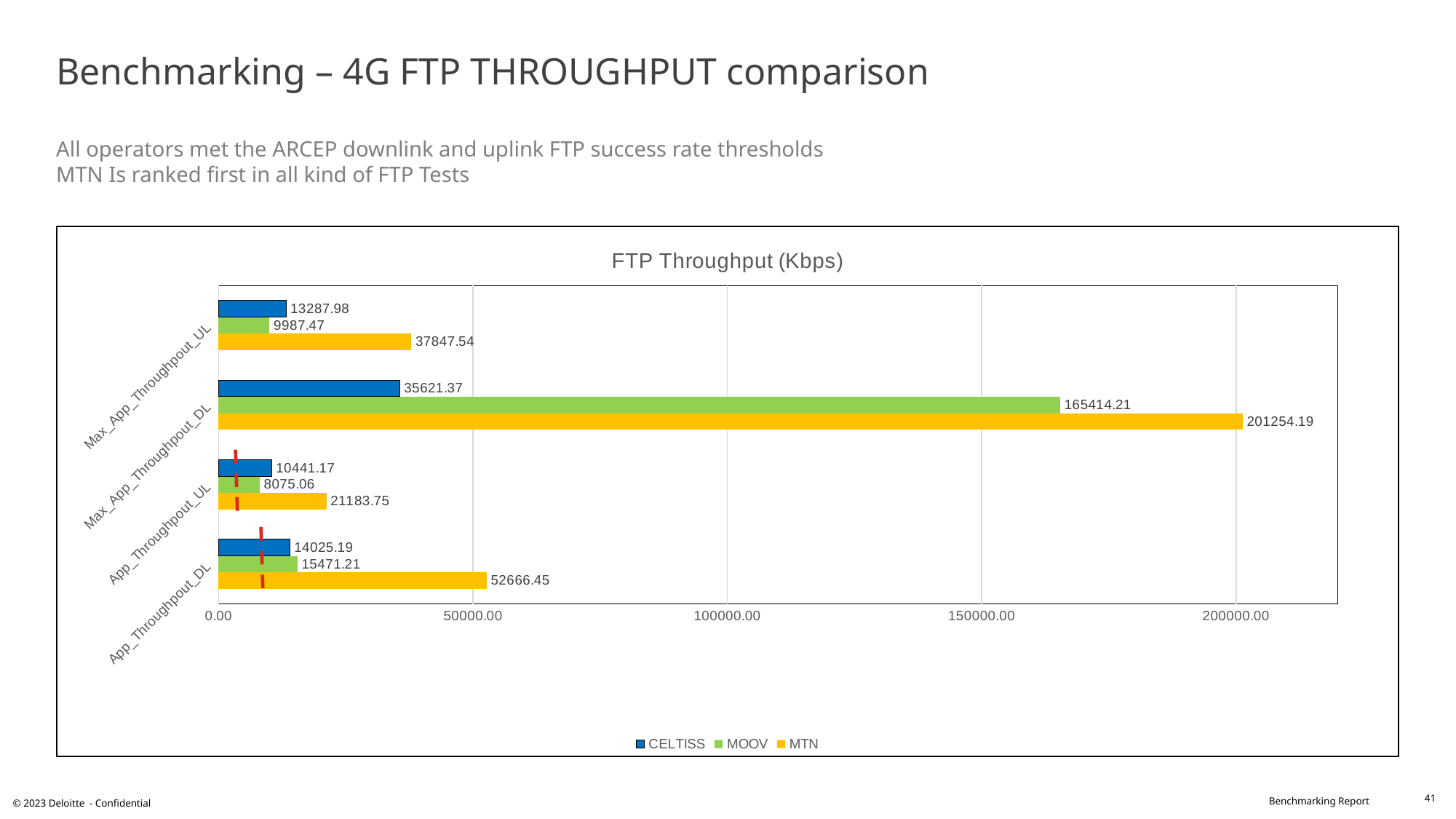
How many categories are shown on the vertical axis of the chart? 4 For App_Throughpout_DL, which is larger: the CELTISS value or the MOOV value? MOOV What type of chart is shown on the slide? Bar chart What is the difference between the MTN and CELTISS values for App_Throughpout_DL? 38641.26 Which operator has the lowest value for App_Throughpout_UL? MOOV What is the difference between the MTN and MOOV values for Max_App_Throughpout_DL? 35839.98 What is the MOOV value for Max_App_Throughpout_UL? 9987.47 Which operator has the highest value for Max_App_Throughpout_DL? MTN What is the MTN value for App_Throughpout_DL? 52666.45 What is the CELTISS value for App_Throughpout_UL? 10441.17 How many series does the legend list? 3 What is the MTN value for Max_App_Throughpout_DL? 201254.19